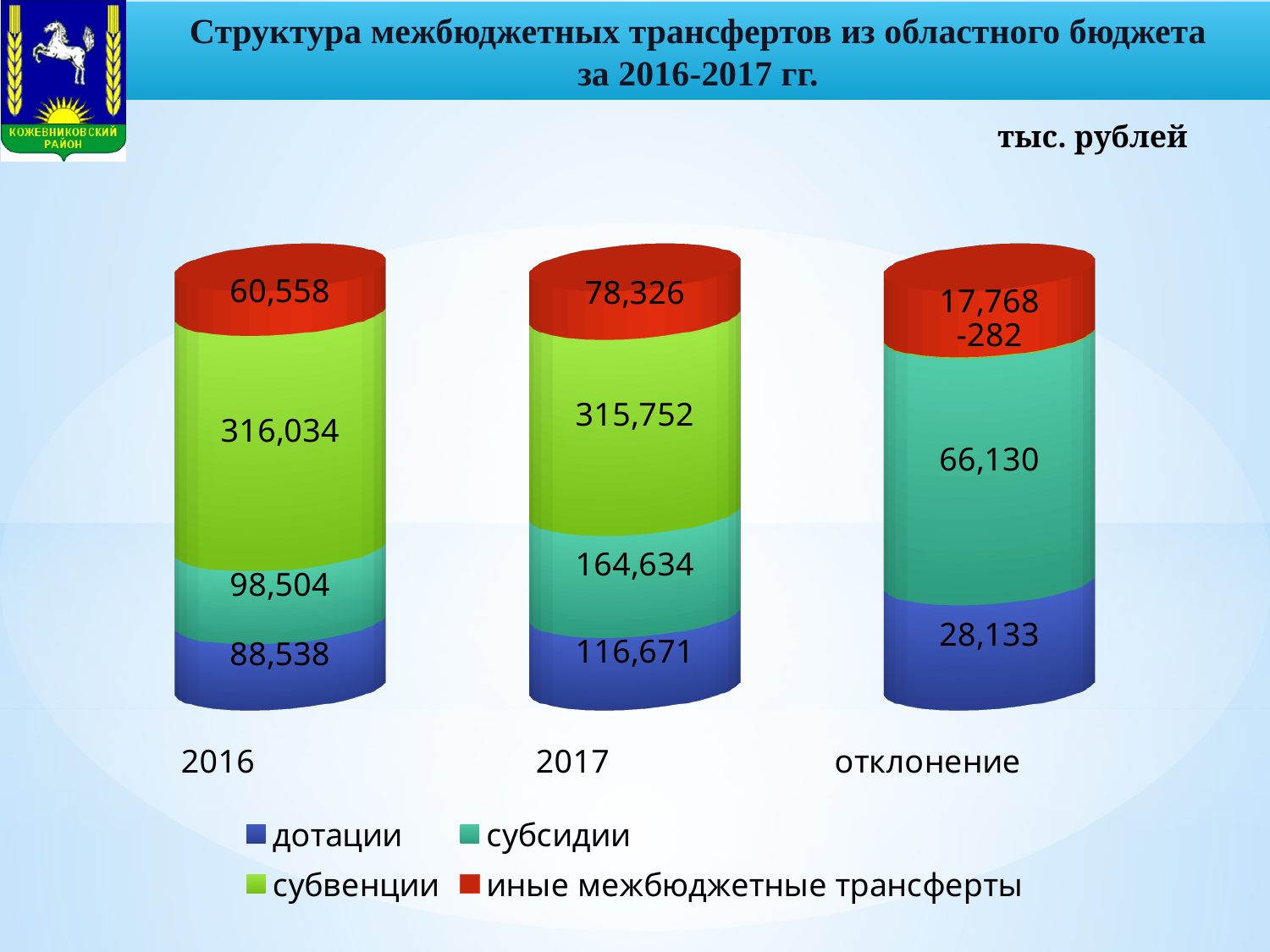
What is the value for субвенции in 2016? 316,034 Which series has the smallest value in the отклонение bar? субвенции What is the value for субсидии in the отклонение bar? 66,130 What is the difference between субсидии in 2017 and субсидии in 2016? 66,130 What kind of chart is shown on the slide? stacked bar chart What is the value for иные межбюджетные трансферты in 2017? 78,326 What is the value for дотации in 2017? 116,671 How many categories are shown on the x axis? 3 How many series does the legend list? 4 Which series has the largest value in the 2016 bar? субвенции Which is larger: дотации in 2016 or дотации in 2017? дотации in 2017 What is the total of the 2016 stacked bar? 563,634